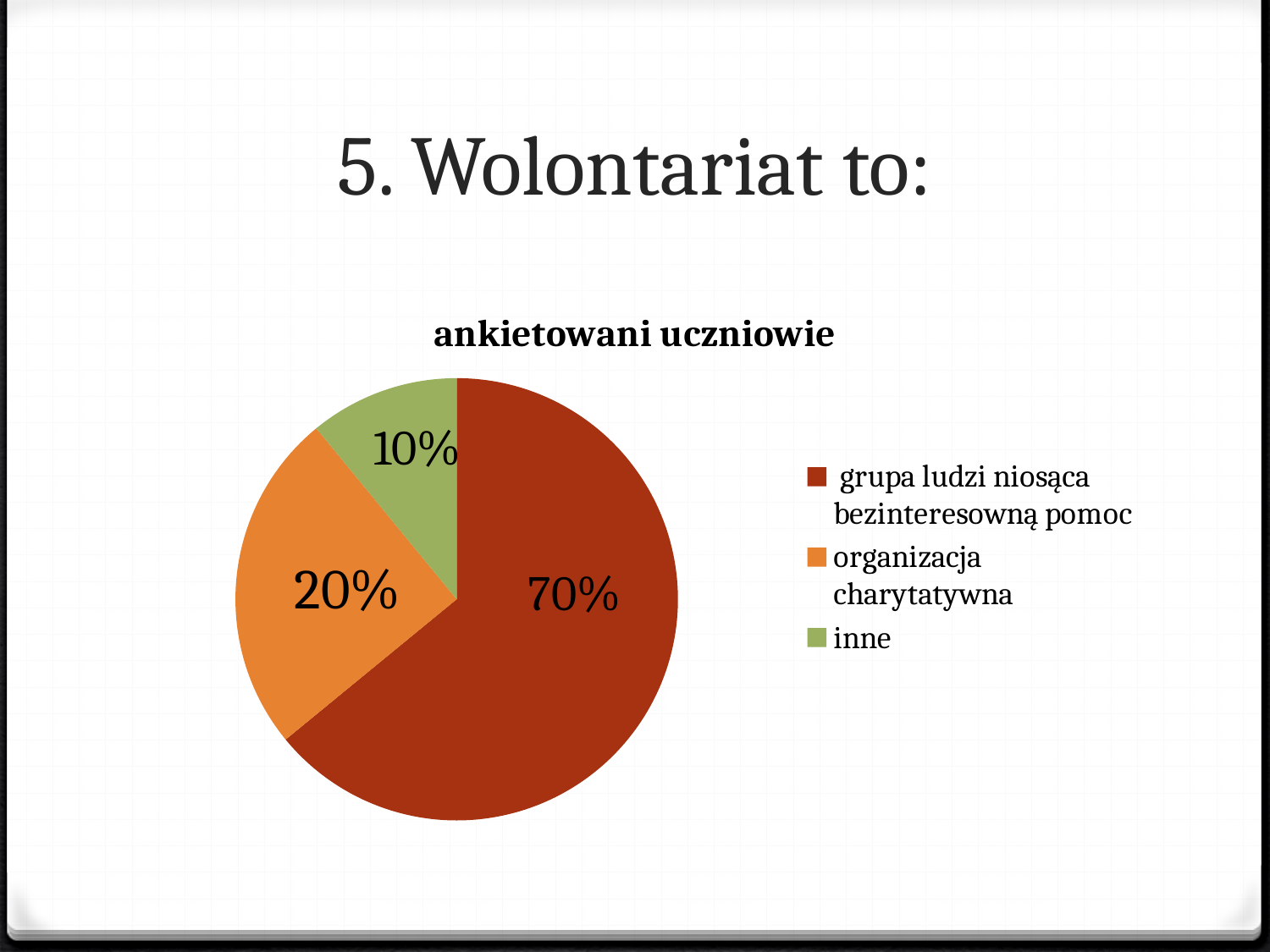
What share of the pie is labelled 'organizacja charytatywna'? 20% What share of the pie is labelled 'inne'? 10% What is the difference in percentage points between 'organizacja charytatywna' and 'inne'? 10 percentage points Which is larger: the slice for 'organizacja charytatywna' or the slice for 'inne'? organizacja charytatywna Which category has the largest slice of the pie? grupa ludzi niosąca bezinteresowną pomoc How many categories does the pie chart have? 3 What is the difference in percentage points between 'grupa ludzi niosąca bezinteresowną pomoc' and 'organizacja charytatywna'? 50 percentage points What colour is the slice for 'inne'? green What kind of chart is shown on the slide? pie chart What is the title of the chart? ankietowani uczniowie What share of the pie is labelled 'grupa ludzi niosąca bezinteresowną pomoc'? 70% Which category has the smallest slice of the pie? inne